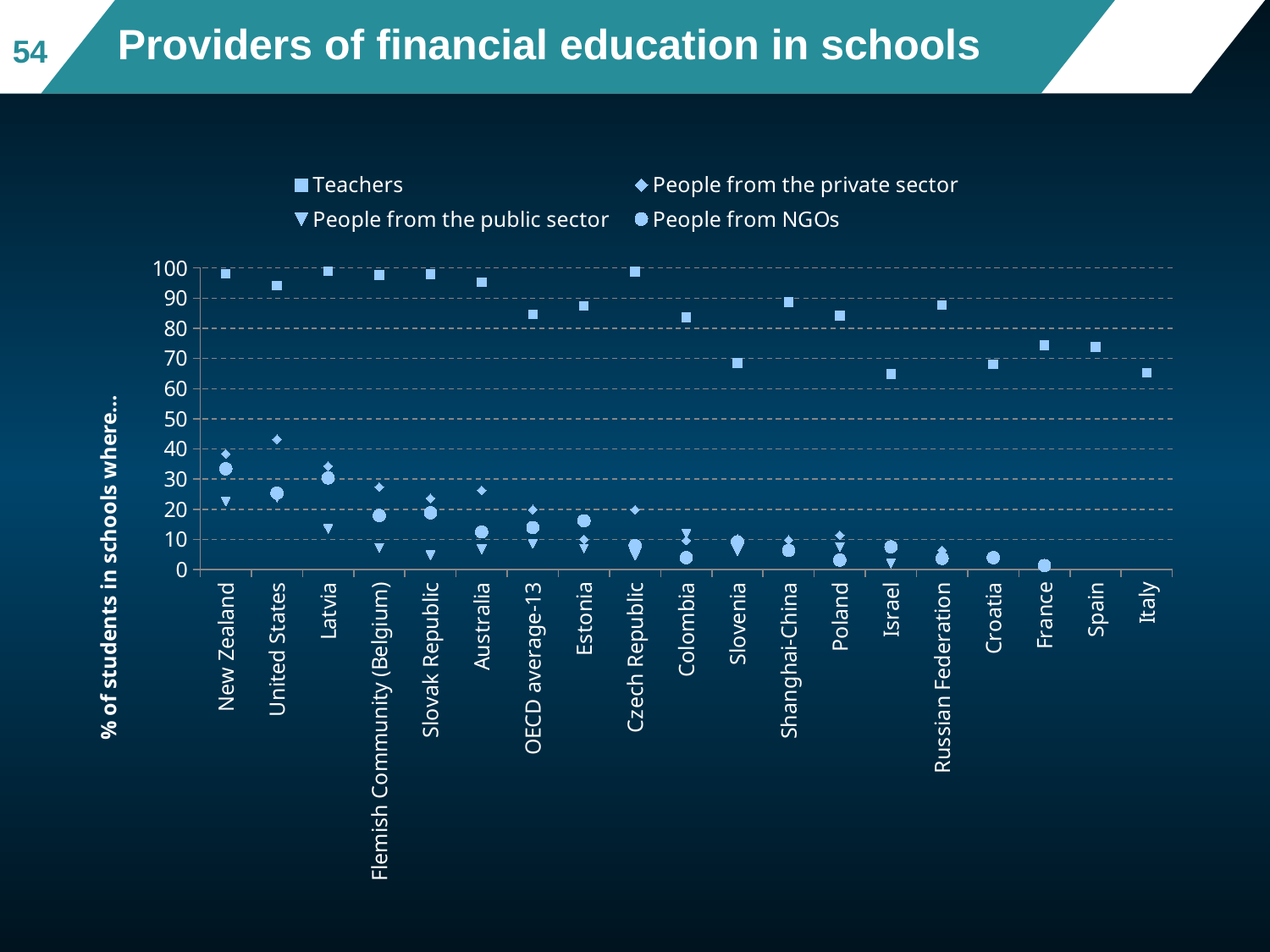
What kind of chart is shown on the slide? scatter chart Which country has the larger Teachers value: New Zealand or Italy? New Zealand Do the Teachers values generally rise or fall moving from left to right along the x axis? fall Is the Teachers value for Italy greater or less than 70? less How many series does the legend list? 4 How many countries or economies are shown on the x axis? 19 Which country has the highest value for People from the private sector? United States What is the title of the chart? Providers of financial education in schools Is the Teachers value for New Zealand greater or less than 90? greater Which is larger for New Zealand: the Teachers value or the People from NGOs value? Teachers Is the People from NGOs value for Flemish Community (Belgium) greater or less than 20? less